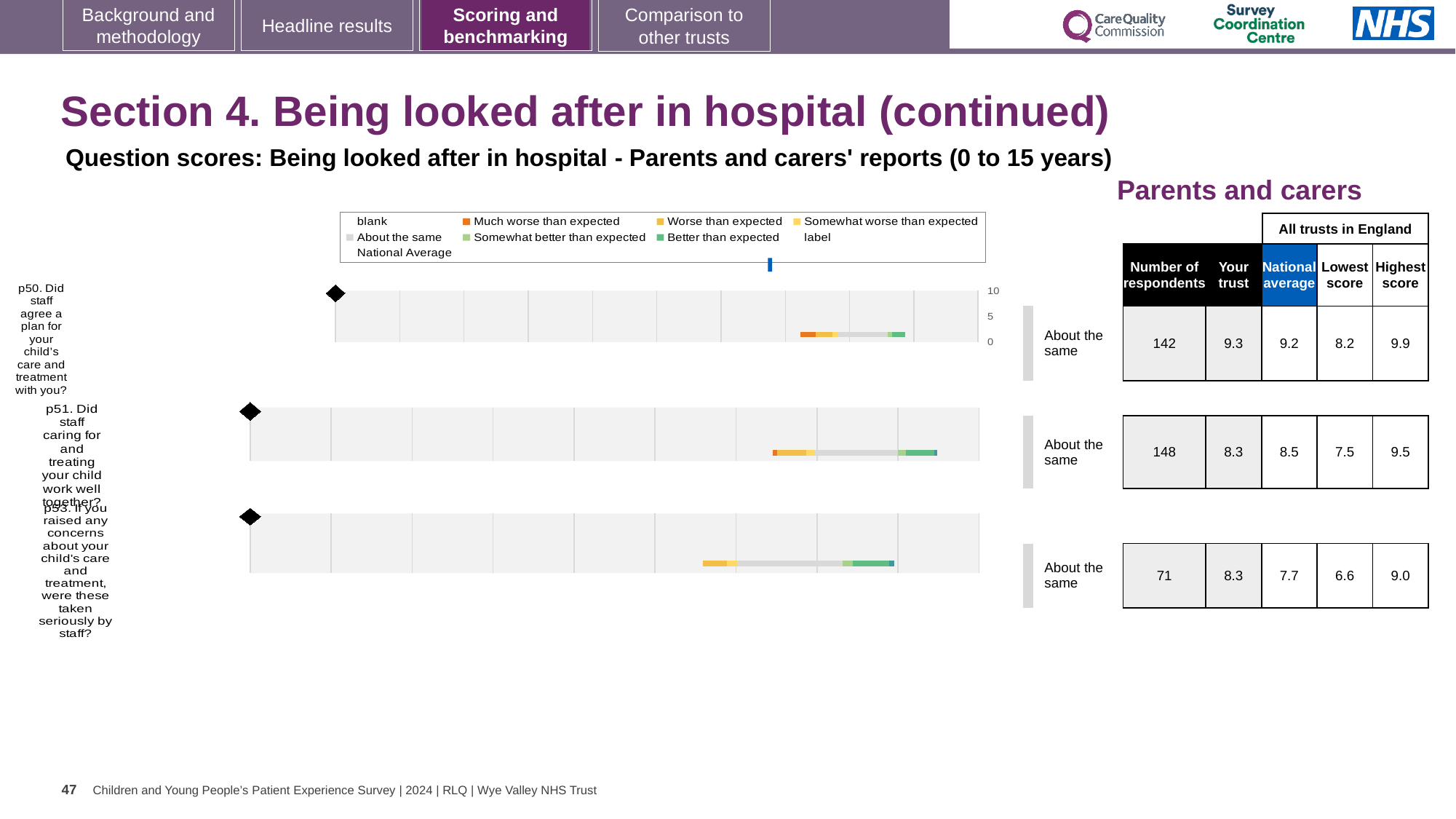
What kind of chart is used to show the question scores for p50, p51 and p53? bar chart In the table, how many respondents are listed for p53 (If you raised any concerns about your child's care and treatment, were these taken seriously by staff)? 71 In the table, what is the 'Your trust' score for p50 (Did staff agree a plan for your child's care and treatment with you)? 9.3 How many entries does the legend above the charts list? 9 How many question charts (p50, p51, p53) are shown on the slide? 3 Which of the three questions has the highest 'Your trust' score in the table? p50 What is the subtitle describing the question scores shown on the slide? Question scores: Being looked after in hospital - Parents and carers' reports (0 to 15 years) What benchmark category is shown next to the p50 chart? About the same What is the highest value shown on the vertical axis of the p50 chart? 10 In the table, what is the national average score for p51 (Did staff caring for and treating your child work well together)? 8.5 For p51, which is larger: the 'Your trust' score or the national average? National average What is the difference between the highest score (9.0) and the lowest score (6.6) for p53 in the table? 2.4